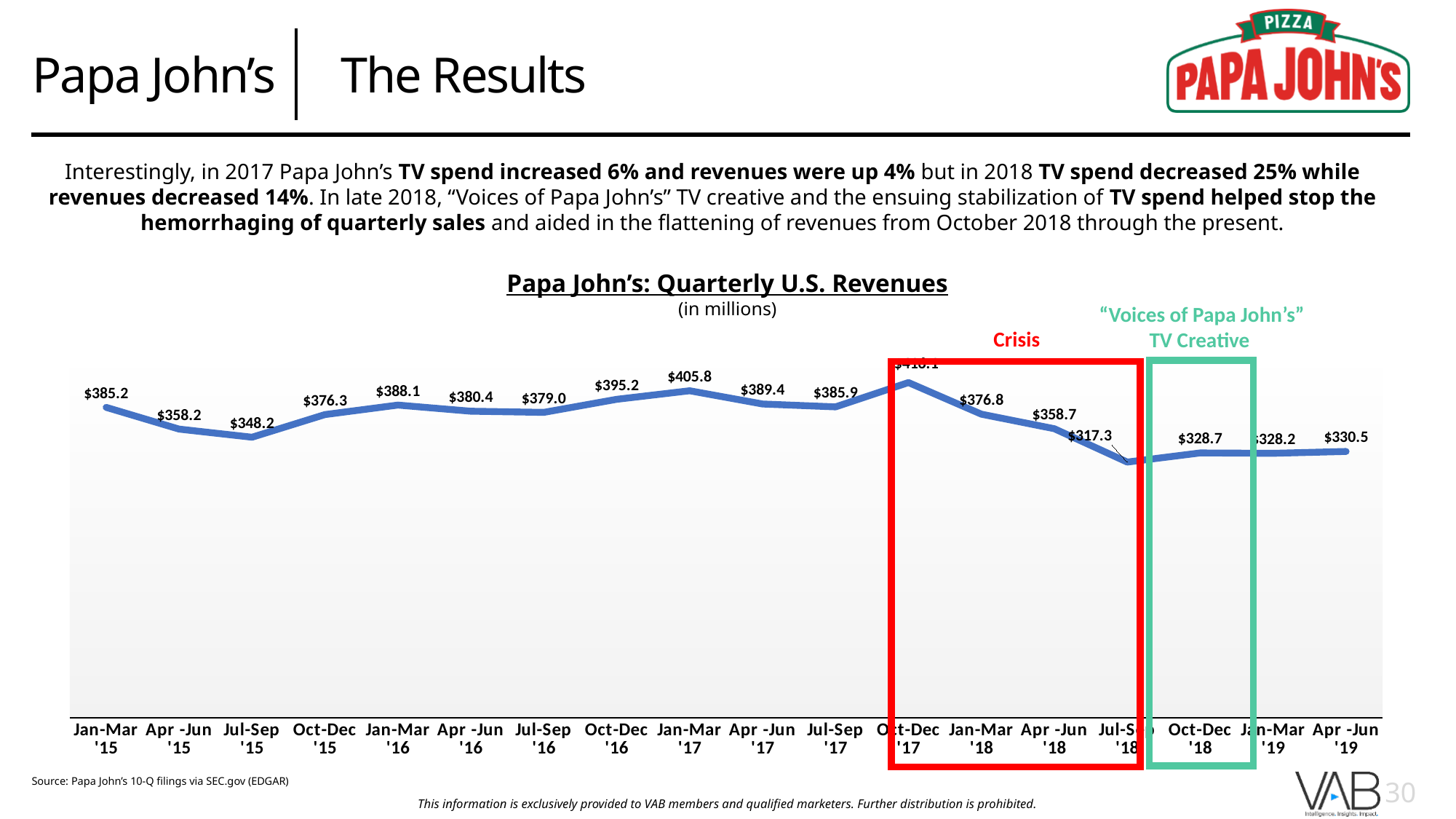
What is the difference in quarterly U.S. revenue between Jan-Mar '18 and Apr-Jun '18? $18.1 What label is given to the period highlighted by the green box? "Voices of Papa John's" TV Creative How many quarters are plotted on the chart? 18 What type of chart is shown on the slide? Line chart What was Papa John's quarterly U.S. revenue in Apr-Jun '19? $330.5 Which quarter had higher U.S. revenue, Oct-Dec '16 or Jul-Sep '15? Oct-Dec '16 What was Papa John's quarterly U.S. revenue in Jan-Mar '17? $405.8 Did quarterly U.S. revenue rise or fall from Jan-Mar '18 to Jul-Sep '18? Fall Which quarter had the lowest quarterly U.S. revenue? Jul-Sep '18 What was Papa John's quarterly U.S. revenue in Jan-Mar '15? $385.2 What was Papa John's quarterly U.S. revenue in Jul-Sep '18? $317.3 What is the difference in quarterly U.S. revenue between Jan-Mar '17 and Jul-Sep '18? $88.5